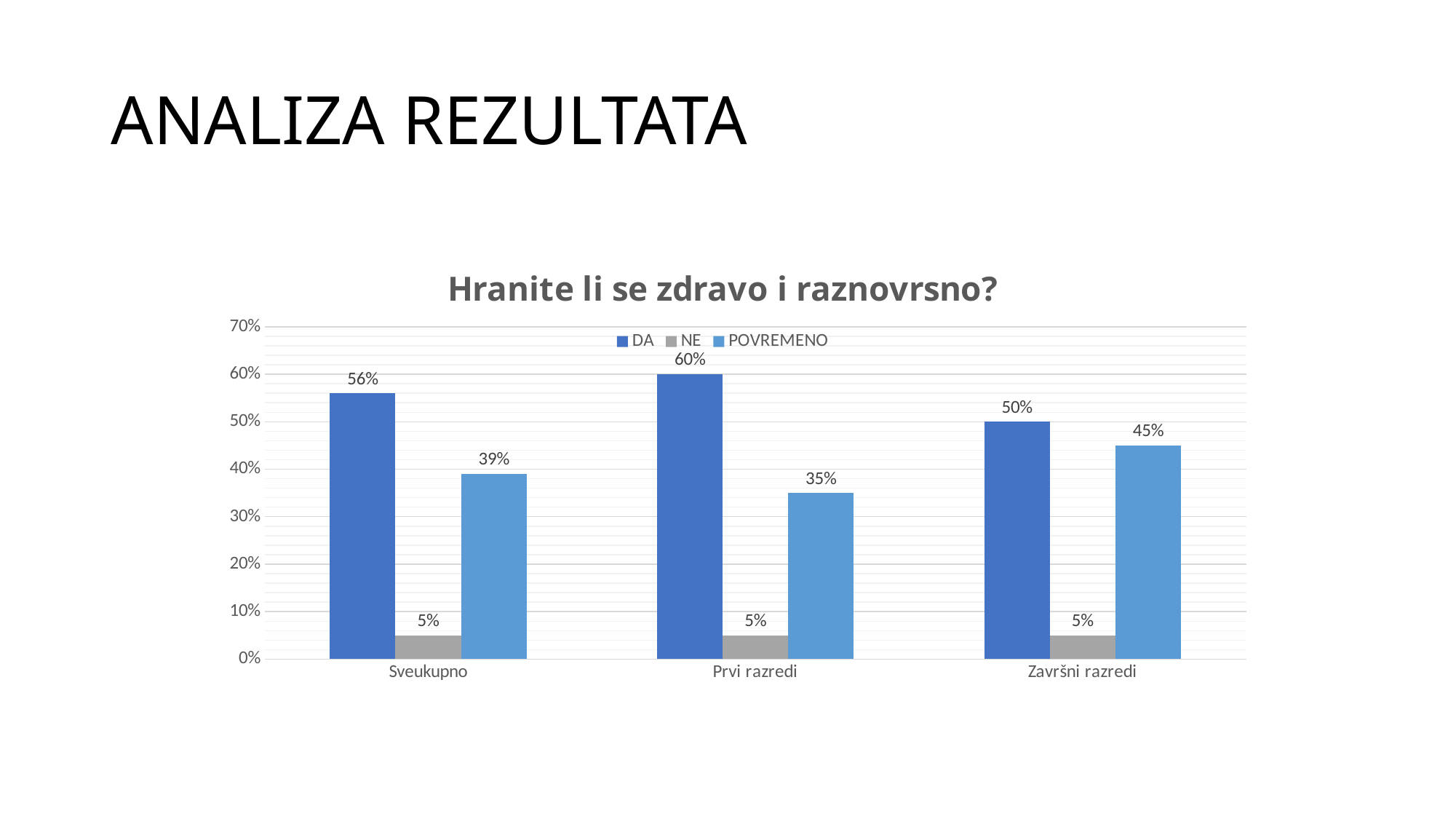
What is the value for DA in the Sveukupno category? 56% What is the value for POVREMENO in the Prvi razredi category? 35% Which is larger in the Sveukupno category, DA or POVREMENO? DA How many categories are shown on the x axis? 3 What is the value for NE in the Završni razredi category? 5% What kind of chart is shown on the slide? Bar chart How many series does the legend list? 3 What is the difference between the DA and POVREMENO values in the Završni razredi category? 5% What is the title of the chart? Hranite li se zdravo i raznovrsno? Which category has the highest DA value? Prvi razredi Which category has the lowest POVREMENO value? Prvi razredi Is the value for DA in Prvi razredi greater or less than 50%? greater